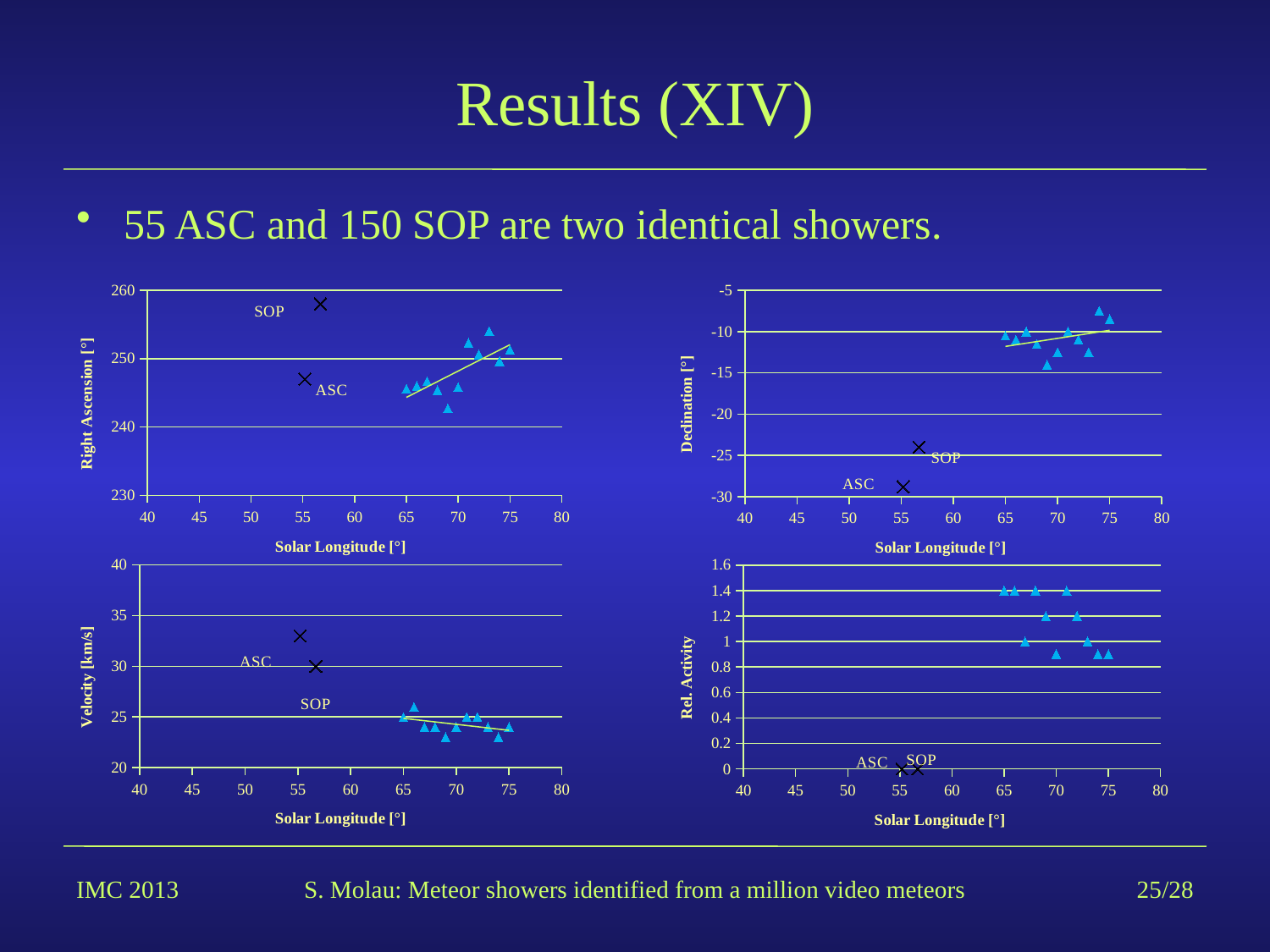
How many charts are shown on the slide? 4 In the Declination chart, which marker is higher, SOP or ASC? SOP In the Velocity chart, do the triangle data points rise or fall as solar longitude increases? fall In the Rel. Activity chart, is the value for the ASC marker greater or less than 0.2? less What is the x-axis label shared by all four charts? Solar Longitude [°] In the Right Ascension chart, which marker is higher, SOP or ASC? SOP In the Velocity chart, is the value for the ASC marker greater or less than 30? greater In the Right Ascension chart, do the triangle data points rise or fall as solar longitude increases? rise What kind of chart is the Right Ascension chart at the top left? scatter chart In the Right Ascension chart, is the value for the SOP marker greater or less than 250? greater